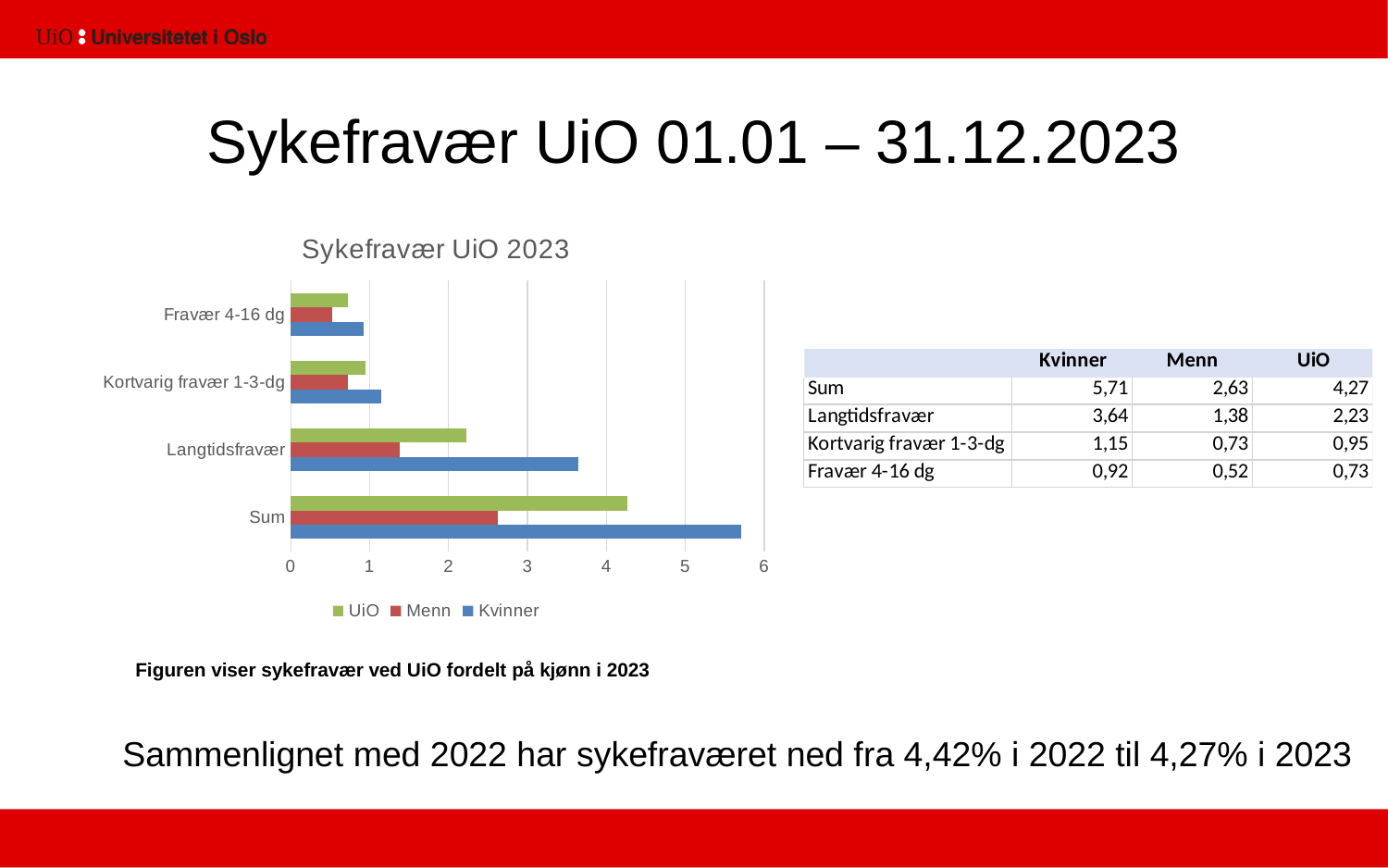
According to the table on the slide, what is the Sum value for Kvinner? 5,71 Using the values in the table, what is the difference between the Kvinner and Menn Sum values? 3,08 Which is larger for Sum: the Kvinner value or the Menn value? Kvinner How many categories are shown on the chart's vertical axis? 4 What kind of chart is shown on the slide? Bar chart According to the table on the slide, what is the Langtidsfravær value for Menn? 1,38 Which category has the lowest Menn value in the chart? Fravær 4-16 dg What is the title of the chart? Sykefravær UiO 2023 According to the table on the slide, what is the Fravær 4-16 dg value for UiO? 0,73 Is the Kvinner value for Langtidsfravær greater or less than 3? greater How many series does the chart legend list? 3 Which category has the highest Kvinner value in the chart? Sum